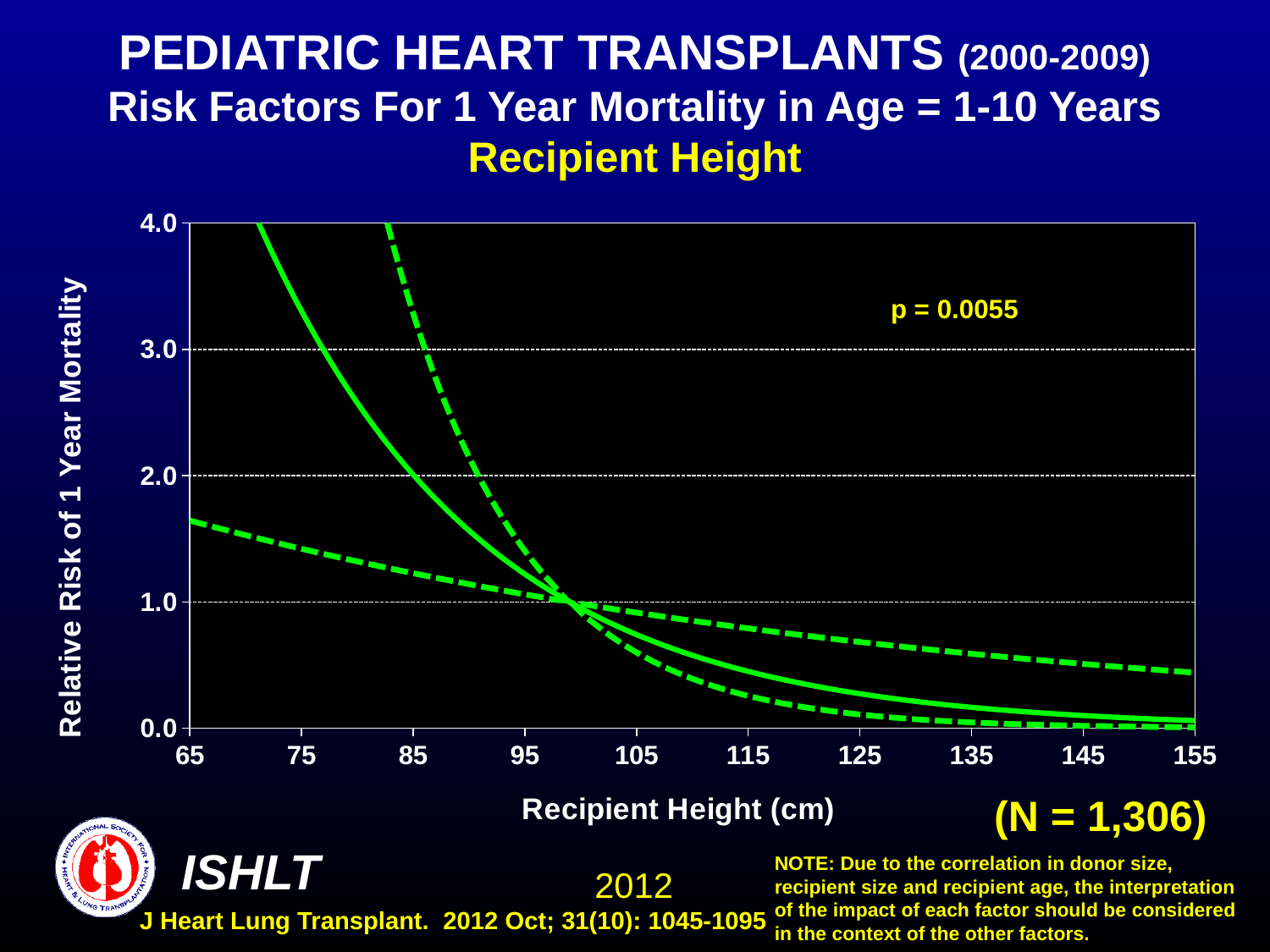
What kind of chart is shown on the slide? line chart Is the relative risk on the solid line at a recipient height of 75 cm greater or less than 3.0? greater Is the relative risk on the solid line at a recipient height of 105 cm greater or less than 1.0? less What is the label of the y axis? Relative Risk of 1 Year Mortality How many tick labels are shown on the x axis (Recipient Height)? 10 Is the relative risk on the solid line higher at a recipient height of 75 cm or at 125 cm? 75 cm Is the relative risk on the solid line at a recipient height of 125 cm greater or less than 1.0? less Does the relative risk of 1 year mortality rise or fall as recipient height increases? fall How many lines are plotted on the chart? 3 What p-value is printed on the chart? p = 0.0055